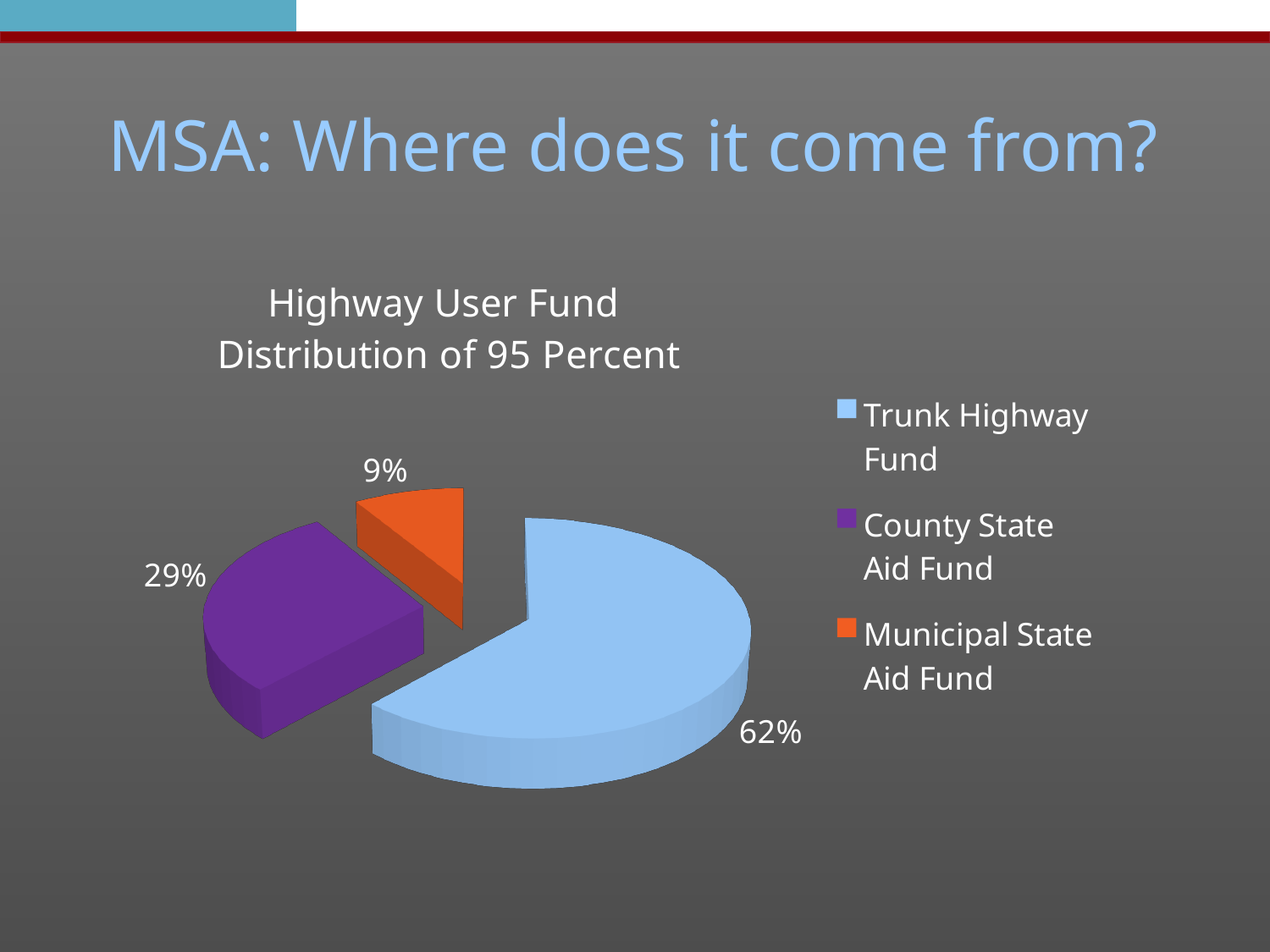
What share of the pie does the Trunk Highway Fund represent? 62% What share of the pie does the Municipal State Aid Fund represent? 9% What colour is the slice for the Municipal State Aid Fund? Orange What share of the pie does the County State Aid Fund represent? 29% What is the difference in percentage points between the Trunk Highway Fund and the County State Aid Fund shares? 33 What kind of chart is shown on the slide? Pie chart How many entries does the legend list? 3 Which has a larger share, the County State Aid Fund or the Municipal State Aid Fund? County State Aid Fund How many slices does the pie chart have? 3 Which fund has the largest share of the pie? Trunk Highway Fund What is the title of the chart? Highway User Fund Distribution of 95 Percent Which fund has the smallest share of the pie? Municipal State Aid Fund